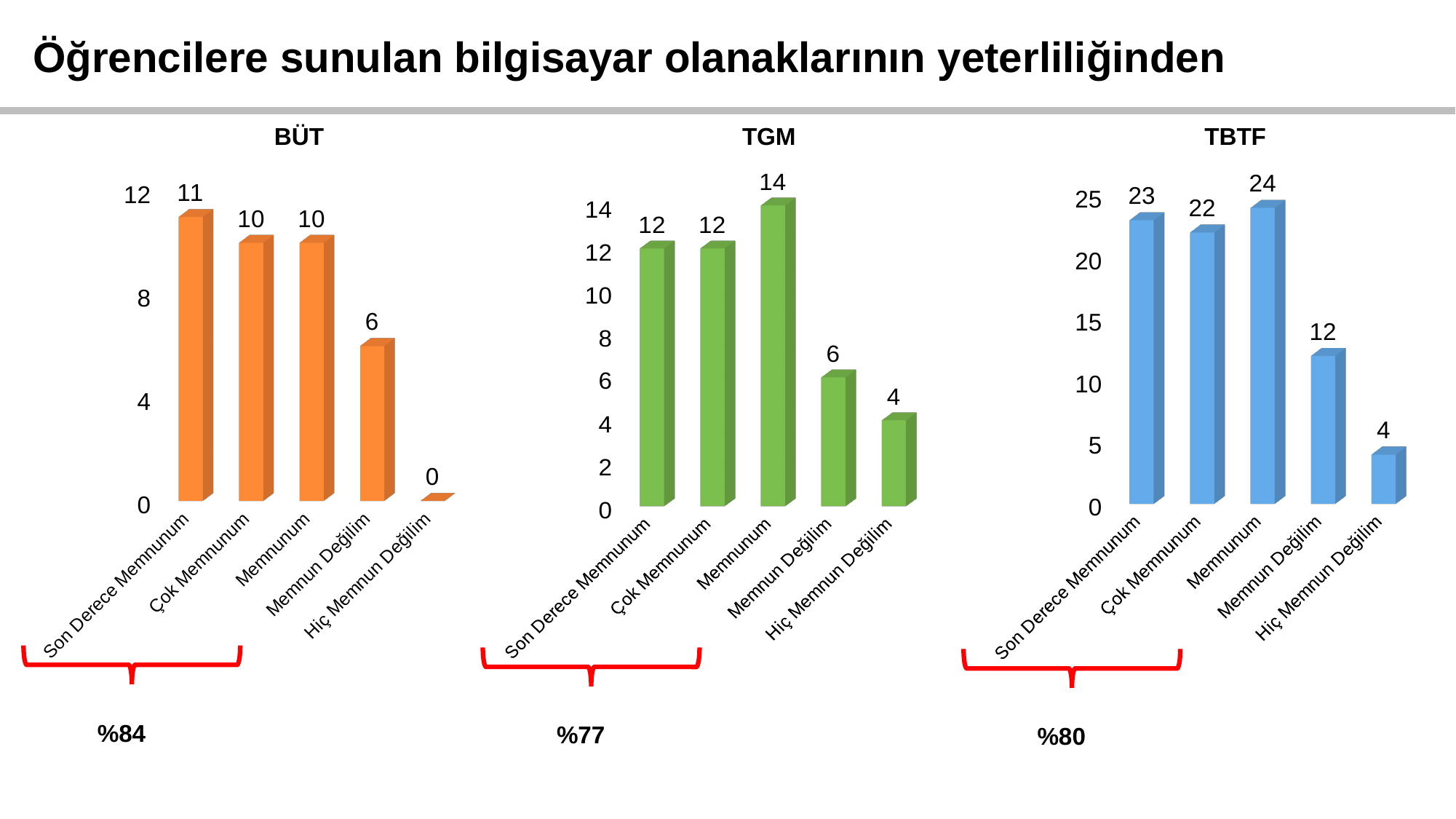
In the TBTF chart, is the value for Memnunum greater or less than 20? greater In the TBTF chart, which category has the highest value? Memnunum In the TBTF chart, do the values rise or fall from Memnunum to Hiç Memnun Değilim? fall What percentage is shown under the bracket beneath the TGM chart? %77 In the TBTF chart, which is larger: Son Derece Memnunum or Çok Memnunum? Son Derece Memnunum In the TBTF chart, what is the value for Memnun Değilim? 12 In the TGM chart, what is the value for Memnunum? 14 In the BÜT chart, which category has the lowest value? Hiç Memnun Değilim In the TGM chart, what is the difference between Memnunum and Hiç Memnun Değilim? 10 What kind of chart is the BÜT chart? bar chart How many categories does the TGM chart show? 5 In the BÜT chart, what is the value for Son Derece Memnunum? 11